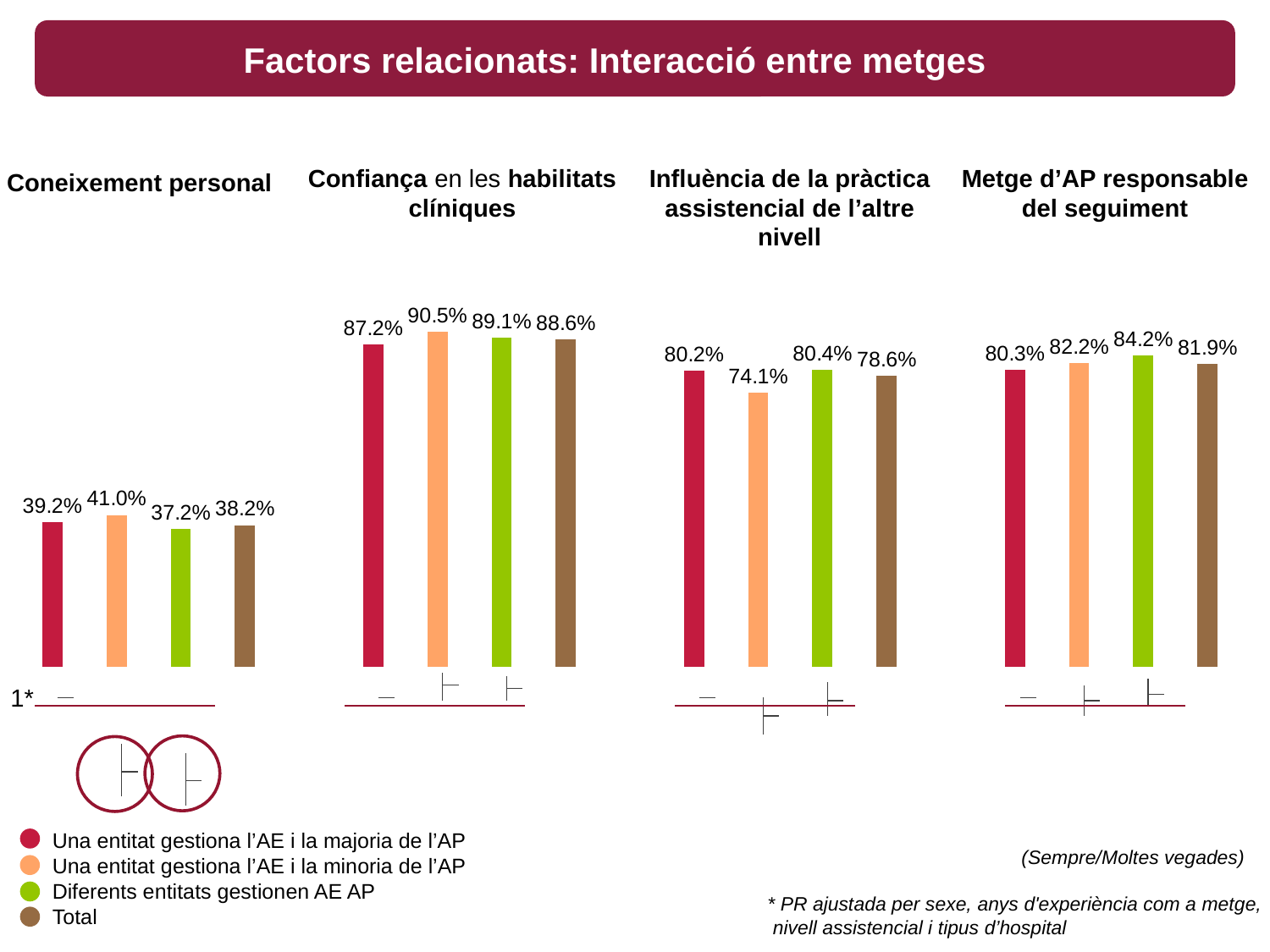
In the 'Coneixement personal' chart, what is the value for 'Total'? 38.2% In the 'Confiança en les habilitats clíniques' chart, which group has the lowest value? Una entitat gestiona l'AE i la majoria de l'AP In the 'Metge d'AP responsable del seguiment' chart, what is the value for 'Diferents entitats gestionen AE AP'? 84.2% In the 'Coneixement personal' chart, which group has the highest value? Una entitat gestiona l'AE i la minoria de l'AP How many groups does the legend list? 4 In the 'Metge d'AP responsable del seguiment' chart, which group has the highest value? Diferents entitats gestionen AE AP In the 'Coneixement personal' chart, what is the difference between the values for 'Una entitat gestiona l'AE i la minoria de l'AP' and 'Diferents entitats gestionen AE AP'? 3.8% What type of chart is used for 'Coneixement personal'? Bar chart In the 'Influència de la pràctica assistencial de l'altre nivell' chart, what is the value for 'Una entitat gestiona l'AE i la minoria de l'AP'? 74.1% In the 'Influència de la pràctica assistencial de l'altre nivell' chart, what is the difference between the 'Total' value and the value for 'Una entitat gestiona l'AE i la minoria de l'AP'? 4.5% Which is larger: the 'Total' value in the 'Confiança en les habilitats clíniques' chart or the 'Total' value in the 'Metge d'AP responsable del seguiment' chart? Confiança en les habilitats clíniques In the 'Confiança en les habilitats clíniques' chart, what is the value for 'Una entitat gestiona l'AE i la minoria de l'AP'? 90.5%